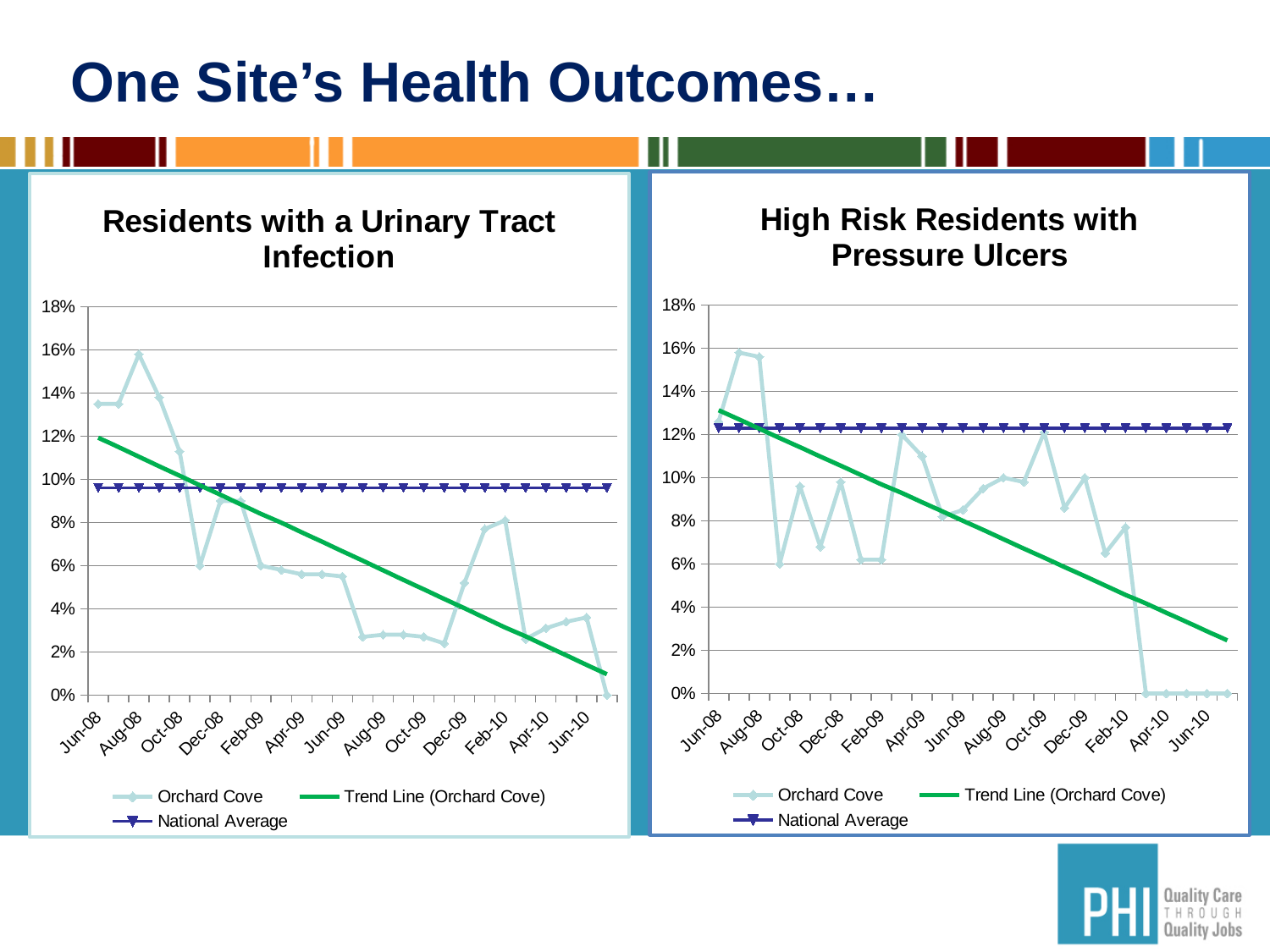
In the 'Residents with a Urinary Tract Infection' chart, is the Orchard Cove value for Aug-09 greater or less than 4%? less In the 'High Risk Residents with Pressure Ulcers' chart, is the National Average line greater or less than 12%? greater In the 'Residents with a Urinary Tract Infection' chart, is the National Average line greater or less than 10%? less What kind of chart is the 'Residents with a Urinary Tract Infection' chart? line chart What is the title of the chart on the right side of the slide? High Risk Residents with Pressure Ulcers In the 'High Risk Residents with Pressure Ulcers' chart, what is the Orchard Cove value for Jun-10? 0% How many series does the legend of the 'High Risk Residents with Pressure Ulcers' chart list? 3 In the 'Residents with a Urinary Tract Infection' chart, at which labelled month does the Orchard Cove line reach its highest value? Aug-08 In the 'Residents with a Urinary Tract Infection' chart, which is larger for Orchard Cove: the value at Jun-08 or the value at Jun-10? Jun-08 In the 'Residents with a Urinary Tract Infection' chart, does the Orchard Cove trend line rise or fall from Jun-08 to Jun-10? fall In the 'High Risk Residents with Pressure Ulcers' chart, does the Orchard Cove trend line rise or fall over time? fall